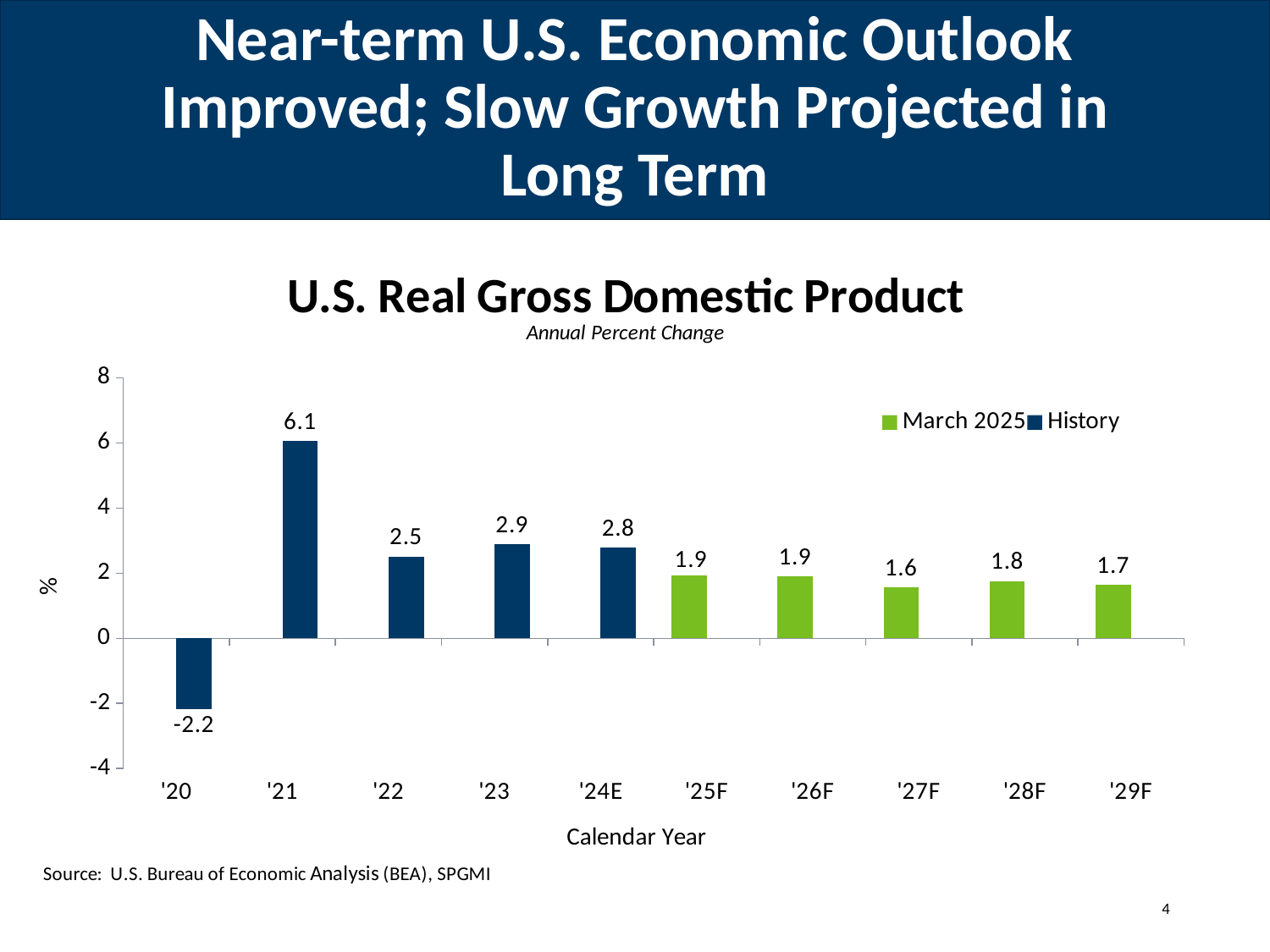
How many series does the legend list? 2 What is the value for '21? 6.1 What is the title of the chart? U.S. Real Gross Domestic Product What kind of chart is this? bar chart Is the value for '21 greater or less than 4? greater What is the value for '27F? 1.6 Which is larger, the value for '22 or the value for '25F? '22 How many years are shown on the x axis? 10 What is the value for '20? -2.2 Which year has the highest value? '21 What is the difference between the values for '23 and '24E? 0.1 Which year has the lowest value? '20